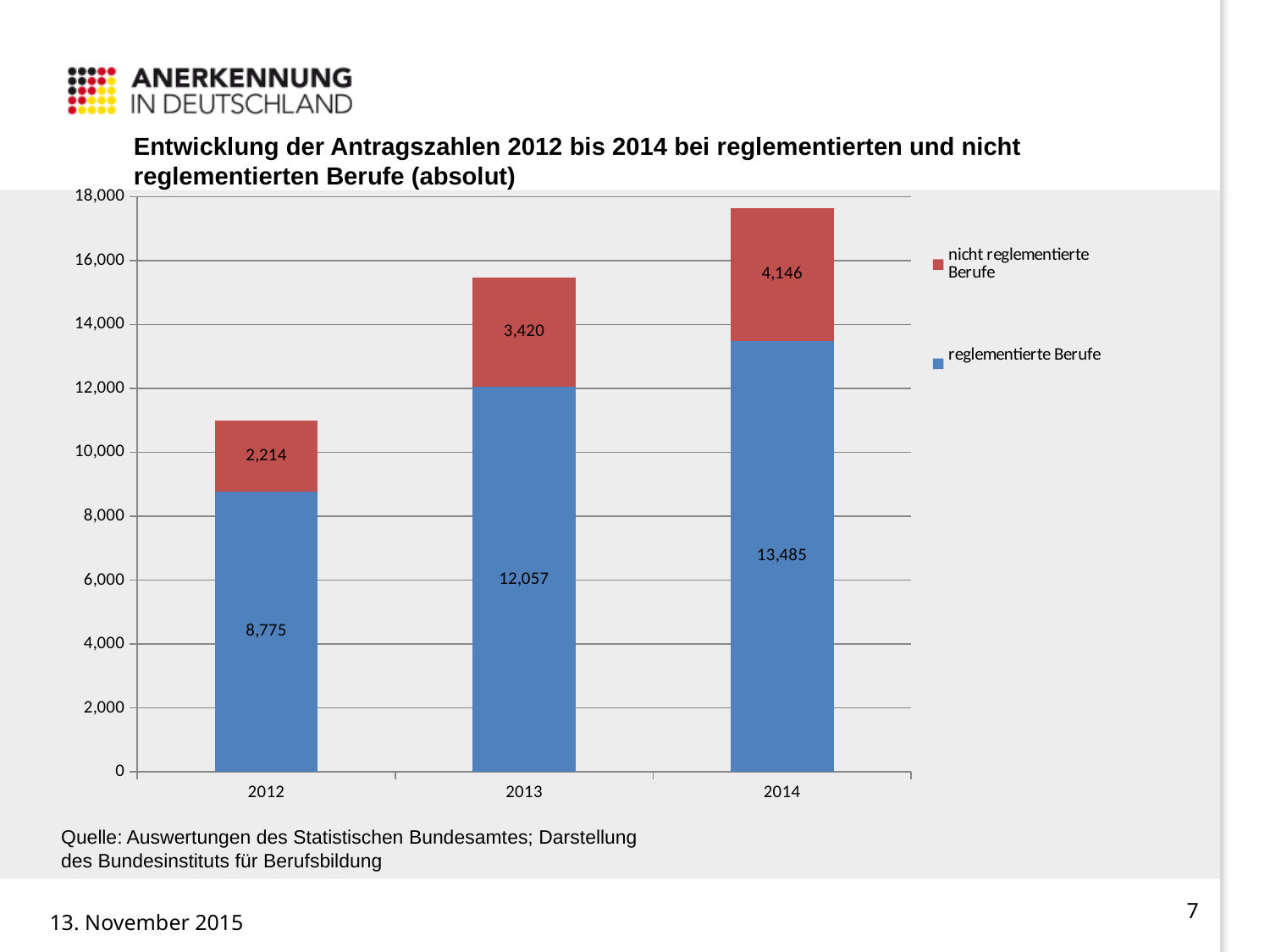
What is the value for reglementierte Berufe in 2012? 8,775 What is the value for nicht reglementierte Berufe in 2013? 3,420 Which year has the highest value for reglementierte Berufe? 2014 What is the difference between the reglementierte Berufe values for 2014 and 2012? 4,710 What is the total of the stacked bar for 2013? 15,477 What is the value for nicht reglementierte Berufe in 2014? 4,146 Do the values for reglementierte Berufe rise or fall from 2012 to 2014? rise Which year has the lowest value for nicht reglementierte Berufe? 2012 Which is larger: reglementierte Berufe in 2013 or reglementierte Berufe in 2014? reglementierte Berufe in 2014 What is the difference between the nicht reglementierte Berufe values for 2014 and 2013? 726 How many series does the legend list? 2 What is the total of the stacked bar for 2014? 17,631